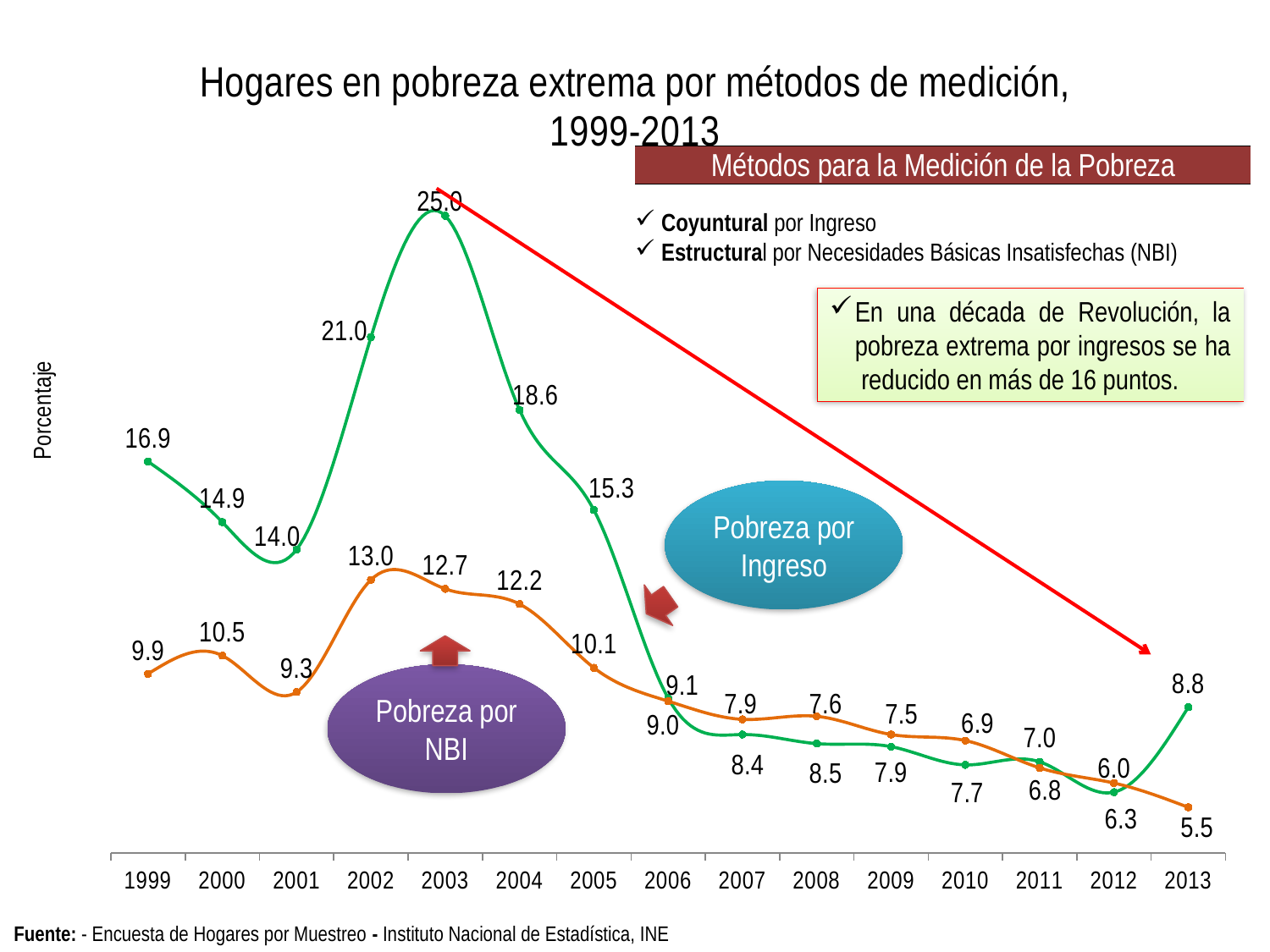
In which year was Pobreza por NBI at its lowest value? 2013 In which year did Pobreza por Ingreso reach its highest value? 2003 What was the value of Pobreza por Ingreso in 2013? 8.8 Which was higher in 2004, Pobreza por Ingreso or Pobreza por NBI? Pobreza por Ingreso Did Pobreza por NBI rise or fall between 2002 and 2013? fall What was the value of Pobreza por Ingreso in 2003? 25.0 How many years are shown on the x axis? 15 What was the value of Pobreza por NBI in 2002? 13.0 How many data series are plotted on the chart? 2 What type of chart is shown on the slide? line chart What was the value of Pobreza por NBI in 2013? 5.5